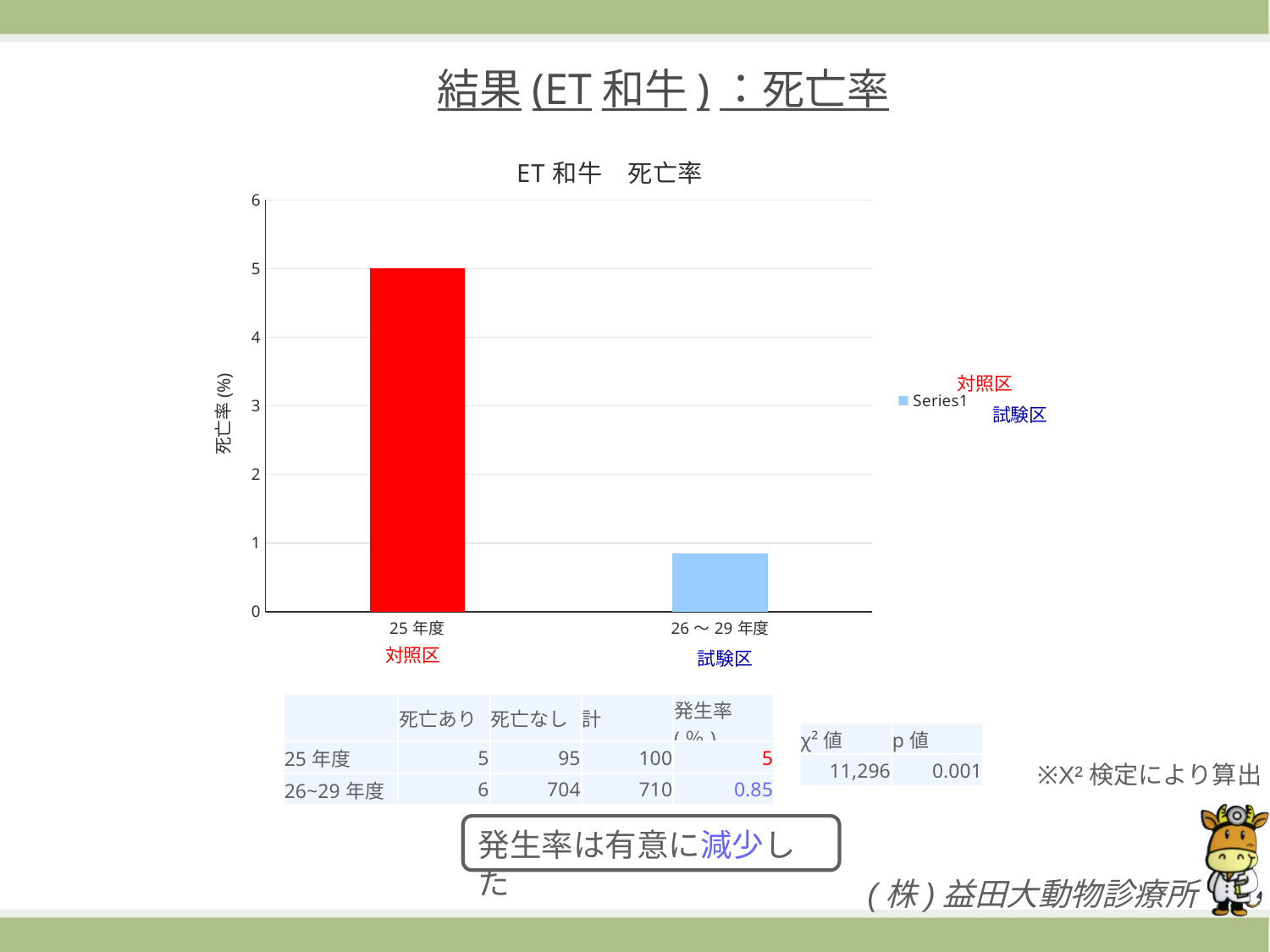
Is the value for 25 年度 greater or less than 4? greater Which category has the highest 死亡率 in the chart? 25 年度 What is the title of the chart? ET 和牛 死亡率 What is the 死亡率 (%) value for 25 年度 in the chart? 5 Which category has the lowest 死亡率 in the chart? 26 ～ 29 年度 Which has the larger 死亡率, 25 年度 or 26 ～ 29 年度? 25 年度 How many categories are plotted on the x axis of the chart? 2 Do the values rise or fall from 25 年度 to 26 ～ 29 年度 along the x axis? fall Is the value for 26 ～ 29 年度 greater or less than 1? less What is the label on the vertical axis of the chart? 死亡率 (%) How many series does the chart legend list? 1 What kind of chart is shown on the slide? bar chart